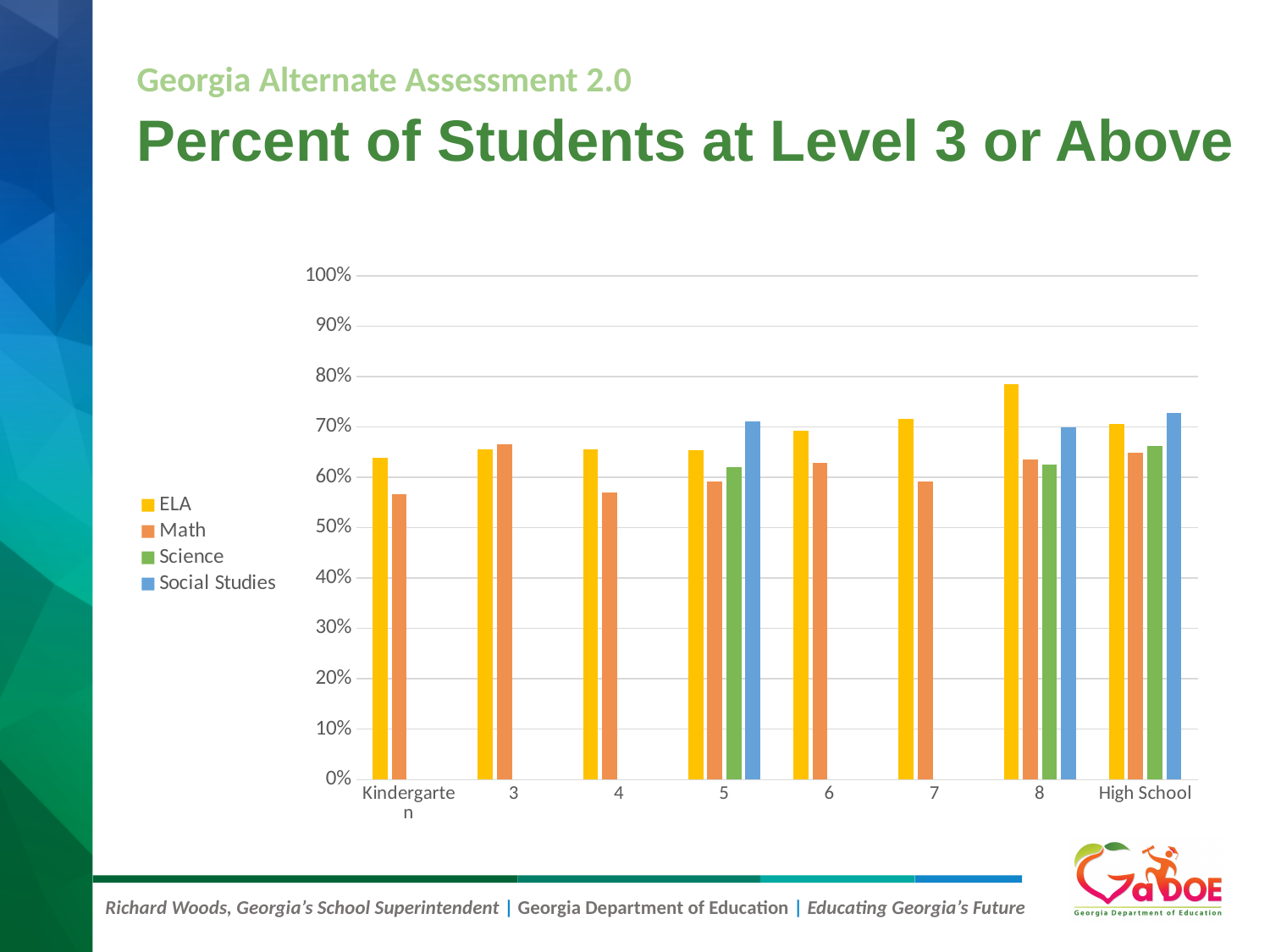
Which series is shown in blue in the legend? Social Studies Is the ELA value for grade 8 greater or less than 70%? greater How many series does the legend list? 4 In grade 5, which is larger, the Social Studies value or the Math value? Social Studies In Kindergarten, which is larger, the ELA value or the Math value? ELA For which grade level is the ELA bar the highest? 8 Is the Math value for Kindergarten greater or less than 60%? less For how many grade levels is a Science bar plotted? 3 What kind of chart is shown on the slide? Bar chart Is the Social Studies value for High School greater or less than 70%? greater How many grade-level categories are shown on the x axis? 8